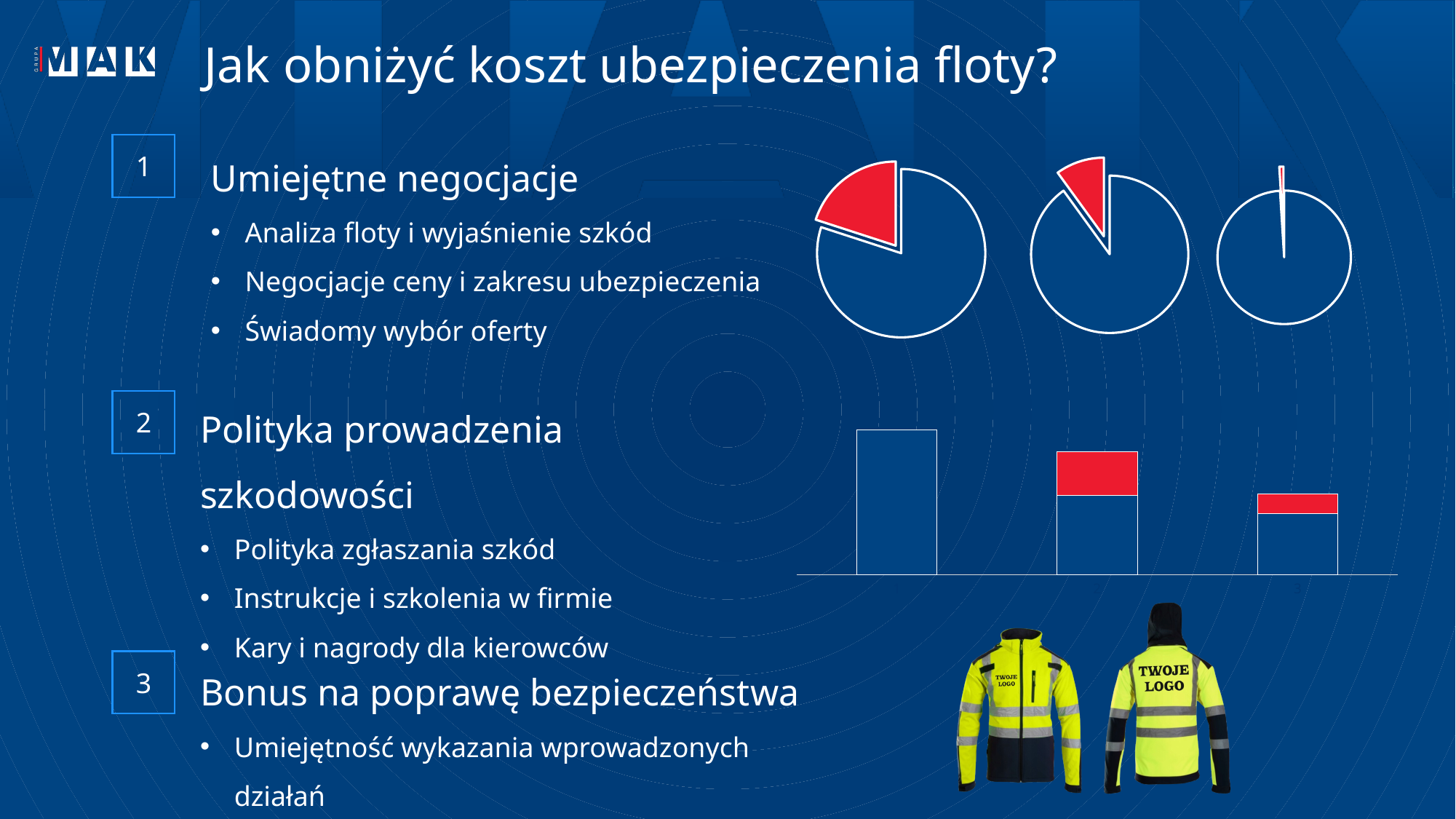
How many pie charts are shown in the upper right of the slide? 3 How many bars does the bar chart in the lower right of the slide have? 3 What two colours are used for the slices in the pie charts in the upper right? blue and red Among the three pie charts in the upper right, which one has the largest red slice? the leftmost pie chart What kind of charts are the three circular graphics in the upper right of the slide? pie charts In the bar chart in the lower right, which bar has no red segment on top? the leftmost bar In the bar chart in the lower right, do the bar heights rise or fall from left to right? fall In the bar chart in the lower right, which bar is the tallest? the leftmost bar What kind of chart is shown in the lower right area of the slide, next to the 'Polityka prowadzenia szkodowości' section? bar chart Among the three pie charts in the upper right, which one has the smallest red slice? the rightmost pie chart In the bar chart in the lower right, which bar is the shortest? the rightmost bar